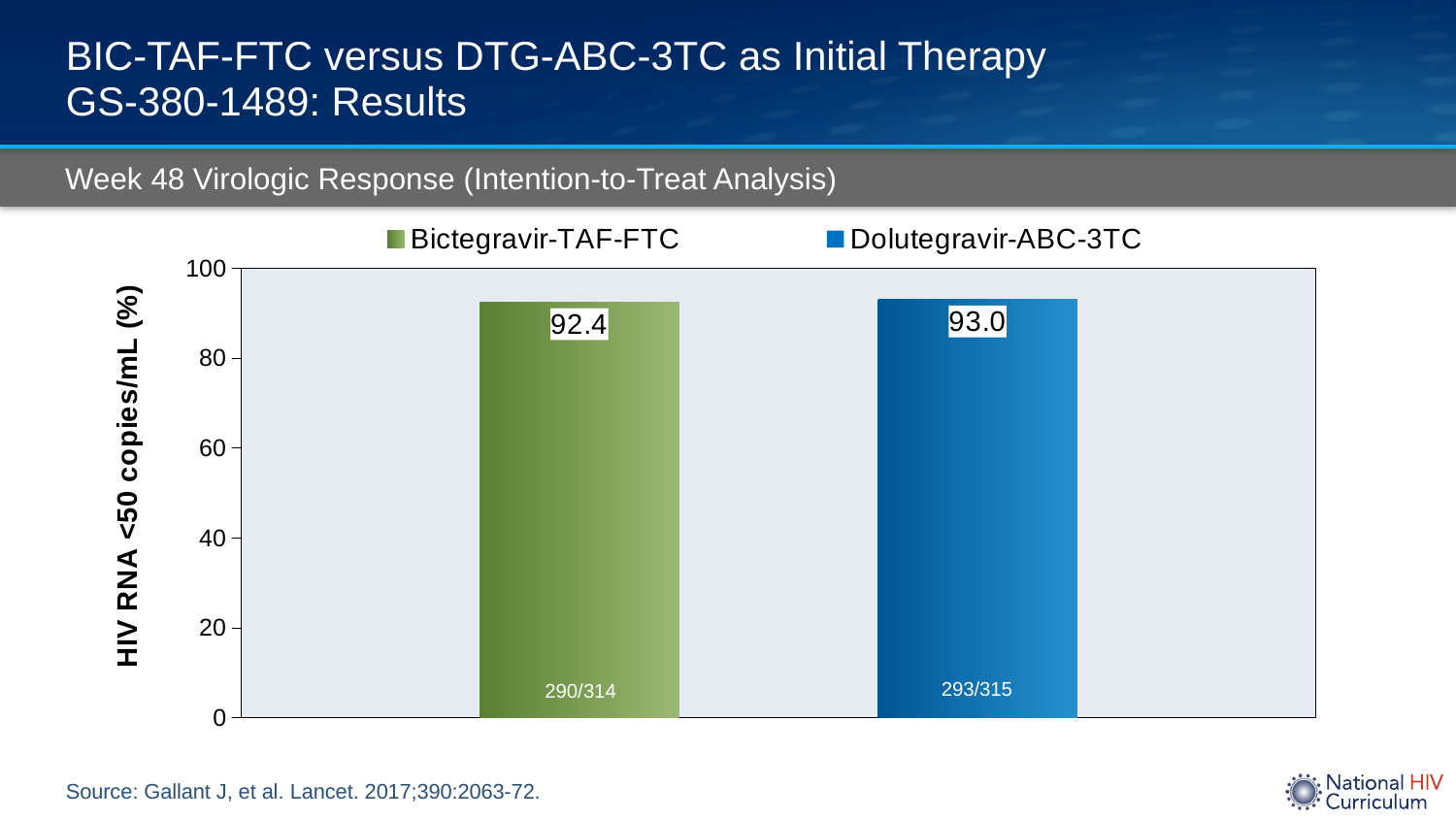
How many series does the legend list? 2 Which treatment arm has the lower Week 48 virologic response value according to the data labels? Bictegravir-TAF-FTC What is the Week 48 virologic response value for Dolutegravir-ABC-3TC? 93.0 Which treatment arm has the higher Week 48 virologic response value according to the data labels? Dolutegravir-ABC-3TC What kind of chart is shown on the slide? Bar chart What fraction of participants is shown at the base of the Dolutegravir-ABC-3TC bar? 293/315 What fraction of participants is shown at the base of the Bictegravir-TAF-FTC bar? 290/314 Is the value for Bictegravir-TAF-FTC greater or less than 80? greater What is the difference between the Dolutegravir-ABC-3TC and Bictegravir-TAF-FTC response values? 0.6 How many bars are plotted in the chart? 2 What is the Week 48 virologic response value for Bictegravir-TAF-FTC? 92.4 What is the label of the y-axis? HIV RNA <50 copies/mL (%)